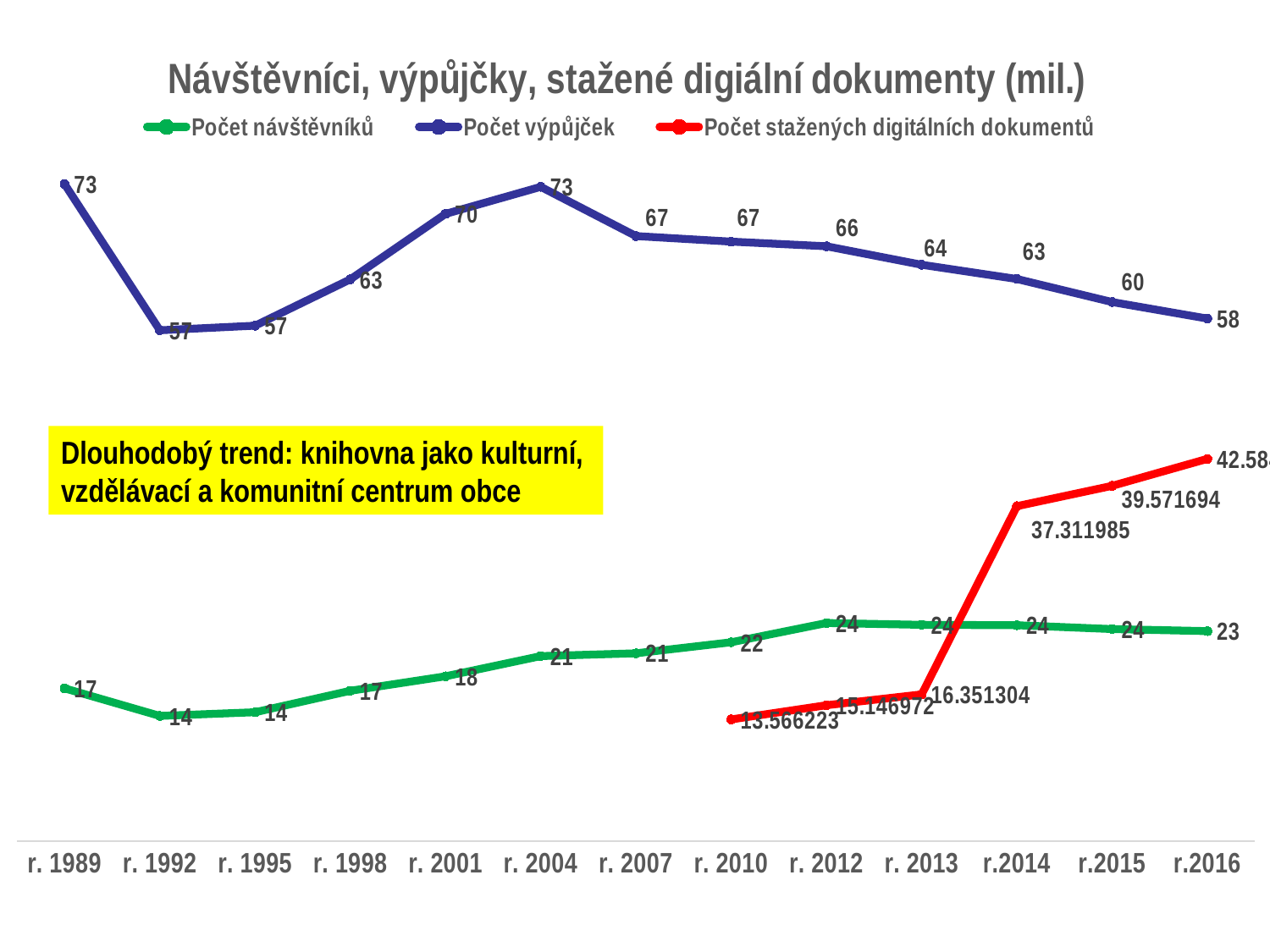
What is the value of Počet návštěvníků for r. 2010? 22 How many series does the legend list? 3 Does Počet výpůjček rise or fall from r. 2004 to r.2016? fall What type of chart is shown on the slide? line chart In which year is Počet stažených digitálních dokumentů highest? r.2016 What is the value of Počet výpůjček for r. 1989? 73 Which is larger for Počet výpůjček: r. 2001 or r. 2007? r. 2001 In which year is Počet stažených digitálních dokumentů lowest? r. 2010 What is the value of Počet stažených digitálních dokumentů for r.2014? 37.311985 What is the value of Počet výpůjček for r.2016? 58 What is the difference between Počet výpůjček in r. 1989 and r.2016? 15 How many years are shown on the x axis? 13